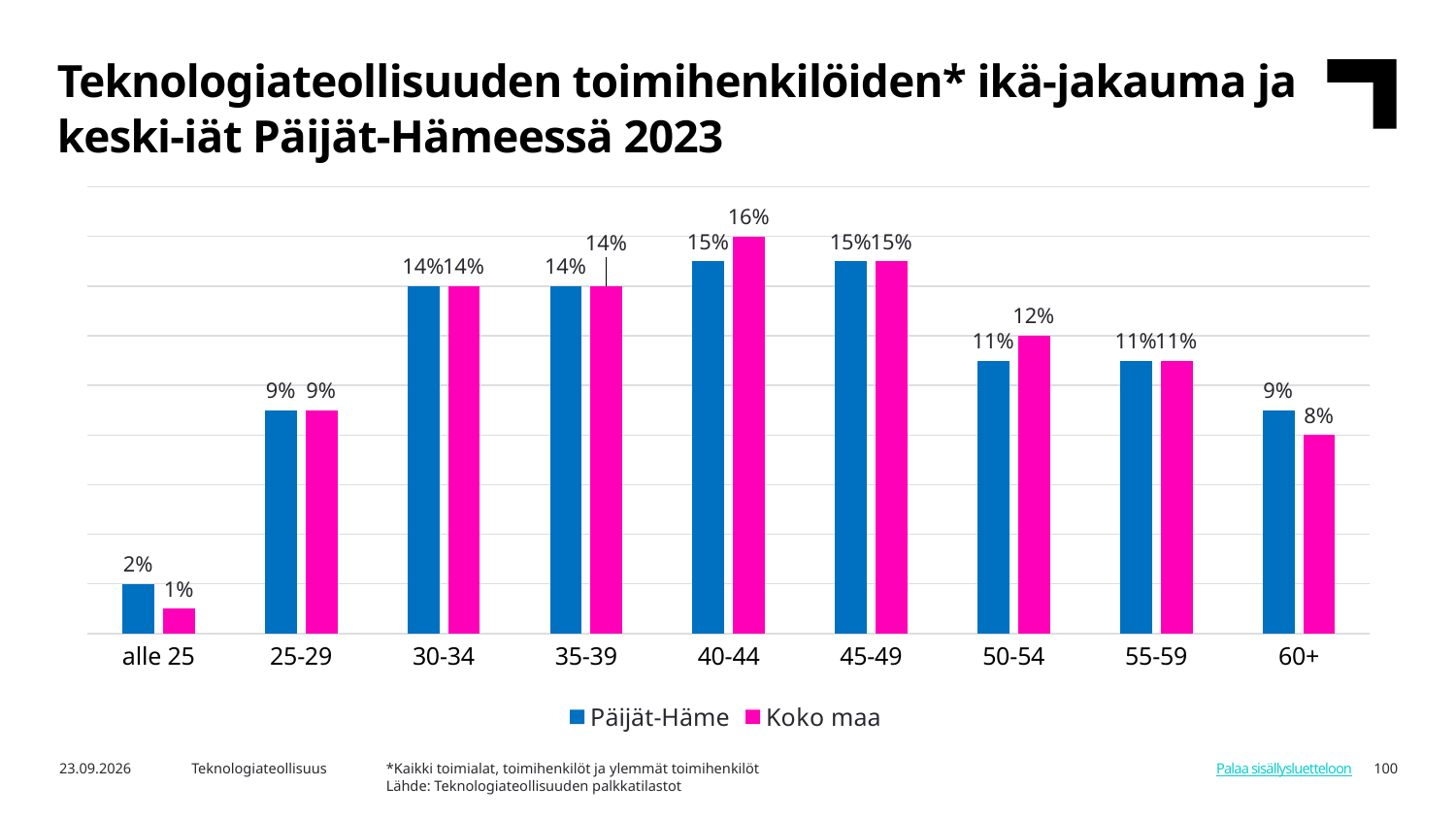
What kind of chart is shown on the slide? Bar chart What is the value for Koko maa in the alle 25 age group? 1% Which age group has the highest value for Koko maa? 40-44 What is the value for Päijät-Häme in the 40-44 age group? 15% Which colour represents the Koko maa series? Pink What is the value for Koko maa in the 40-44 age group? 16% What is the difference between the Koko maa and Päijät-Häme values in the 50-54 age group? 1% Which age group has the lowest value for Päijät-Häme? alle 25 What is the value for Päijät-Häme in the 60+ age group? 9% In the 60+ age group, which series has the larger value, Päijät-Häme or Koko maa? Päijät-Häme How many series does the legend list? 2 How many age groups are shown on the x axis? 9